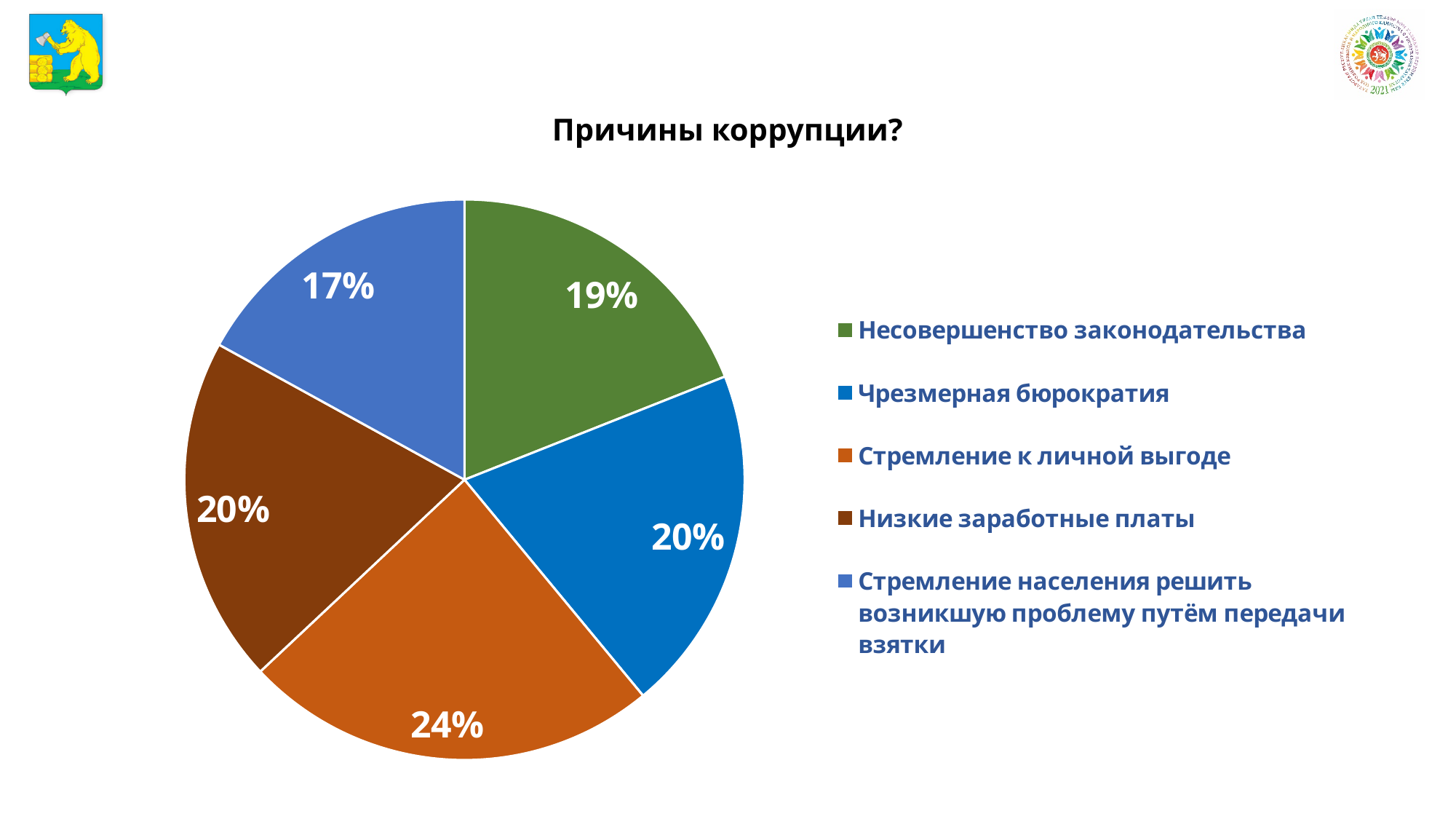
What is the title of the chart? Причины коррупции? What is the difference in percentage points between "Стремление к личной выгоде" and "Несовершенство законодательства"? 5 Which category has the smallest slice of the pie? Стремление населения решить возникшую проблему путём передачи взятки What share of the pie is labelled for "Несовершенство законодательства"? 19% What colour is the slice for "Несовершенство законодательства"? Green How many categories does the legend list? 5 What share of the pie is labelled for "Низкие заработные платы"? 20% What share of the pie is labelled for "Стремление населения решить возникшую проблему путём передачи взятки"? 17% What share of the pie is labelled for "Стремление к личной выгоде"? 24% Which category has the largest slice of the pie? Стремление к личной выгоде Which is larger: the slice for "Чрезмерная бюрократия" or the slice for "Несовершенство законодательства"? Чрезмерная бюрократия What kind of chart is shown on the slide? Pie chart